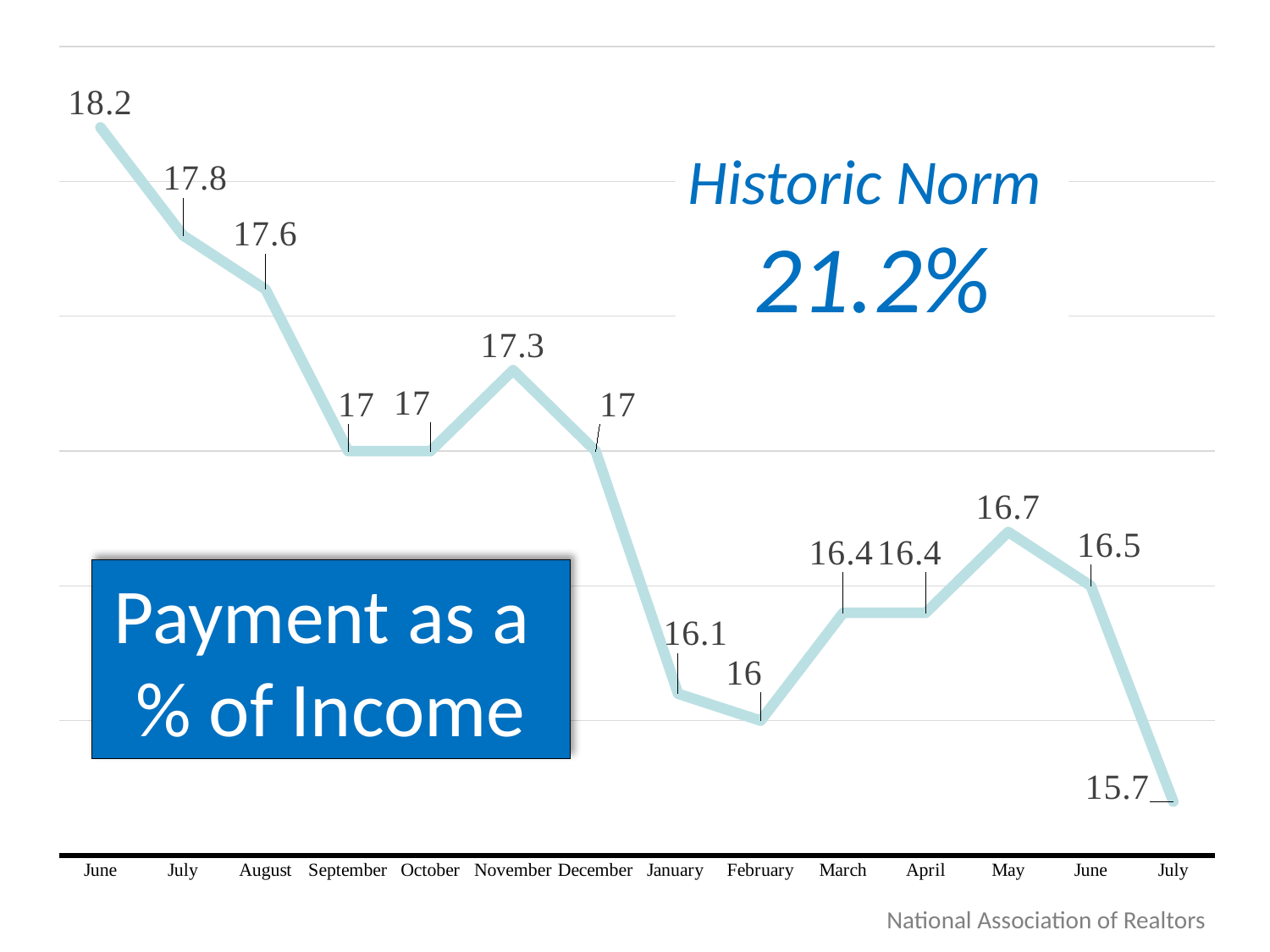
Overall, do the values rise or fall from the first June to the last July? fall What is the value for February? 16 What is the value for the last July on the x axis? 15.7 What historic norm value is stated on the slide? 21.2% What type of chart is shown on the slide? line chart Which is larger, the value for May or the value for January? May Which month has the lowest value? July (the last one) How many data points are plotted on the line? 14 What is the difference between the value for the first June (18.2) and the last July (15.7)? 2.5 What is the value for the first June on the x axis? 18.2 Which month has the highest value? June (the first one) What is the value for November? 17.3